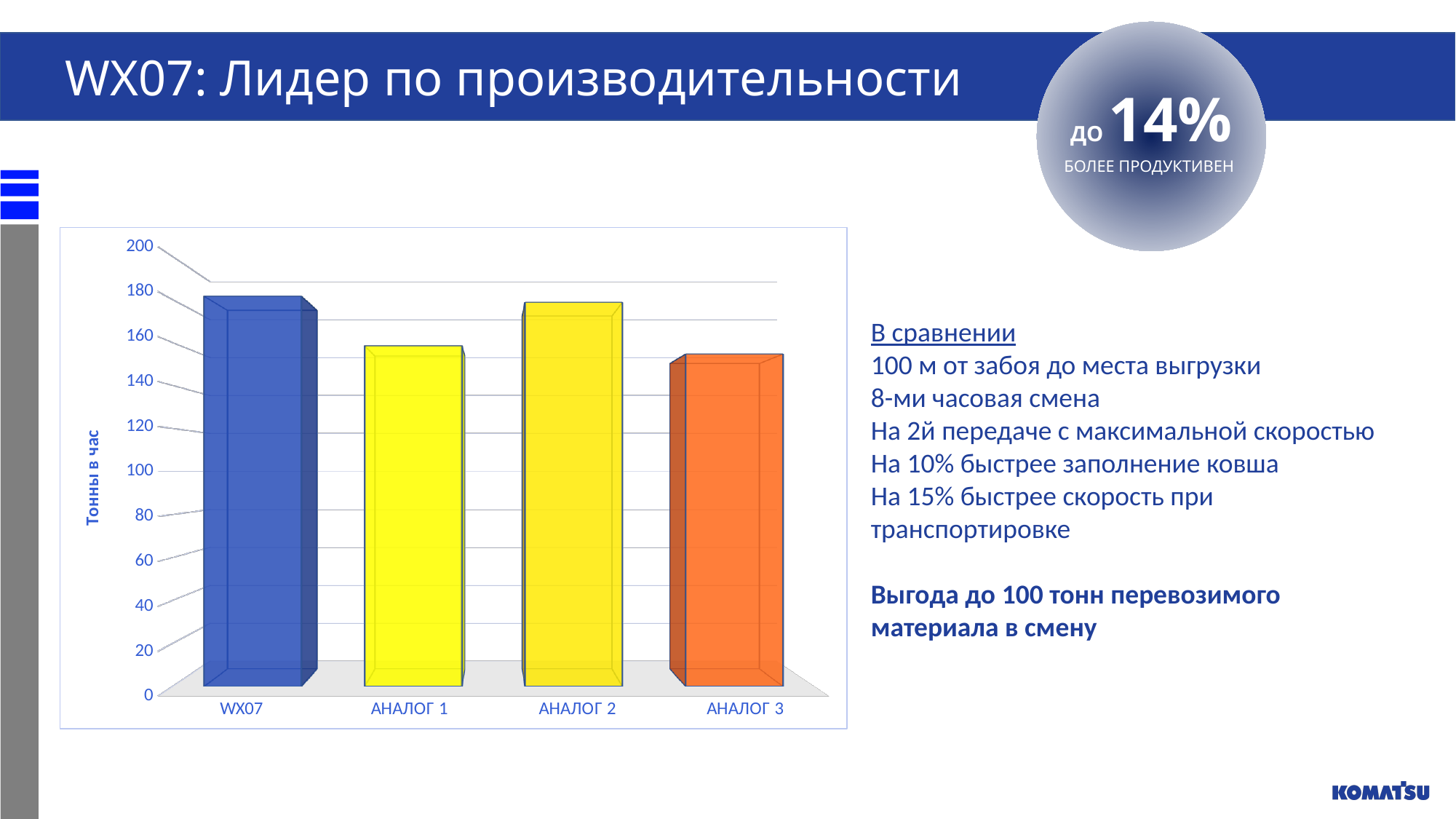
Is the value for АНАЛОГ 1 greater or less than 140? greater What colour is the bar for WX07? blue Is the value for АНАЛОГ 1 greater or less than 180? less What kind of chart is shown on the slide? bar chart How many categories are shown on the x axis of the chart? 4 Is the value for АНАЛОГ 2 greater or less than 160? greater Which has a higher value, WX07 or АНАЛОГ 3? WX07 What is the label of the vertical axis of the chart? Тонны в час Which has a higher value, WX07 or АНАЛОГ 1? WX07 Which has a higher value, АНАЛОГ 2 or АНАЛОГ 3? АНАЛОГ 2